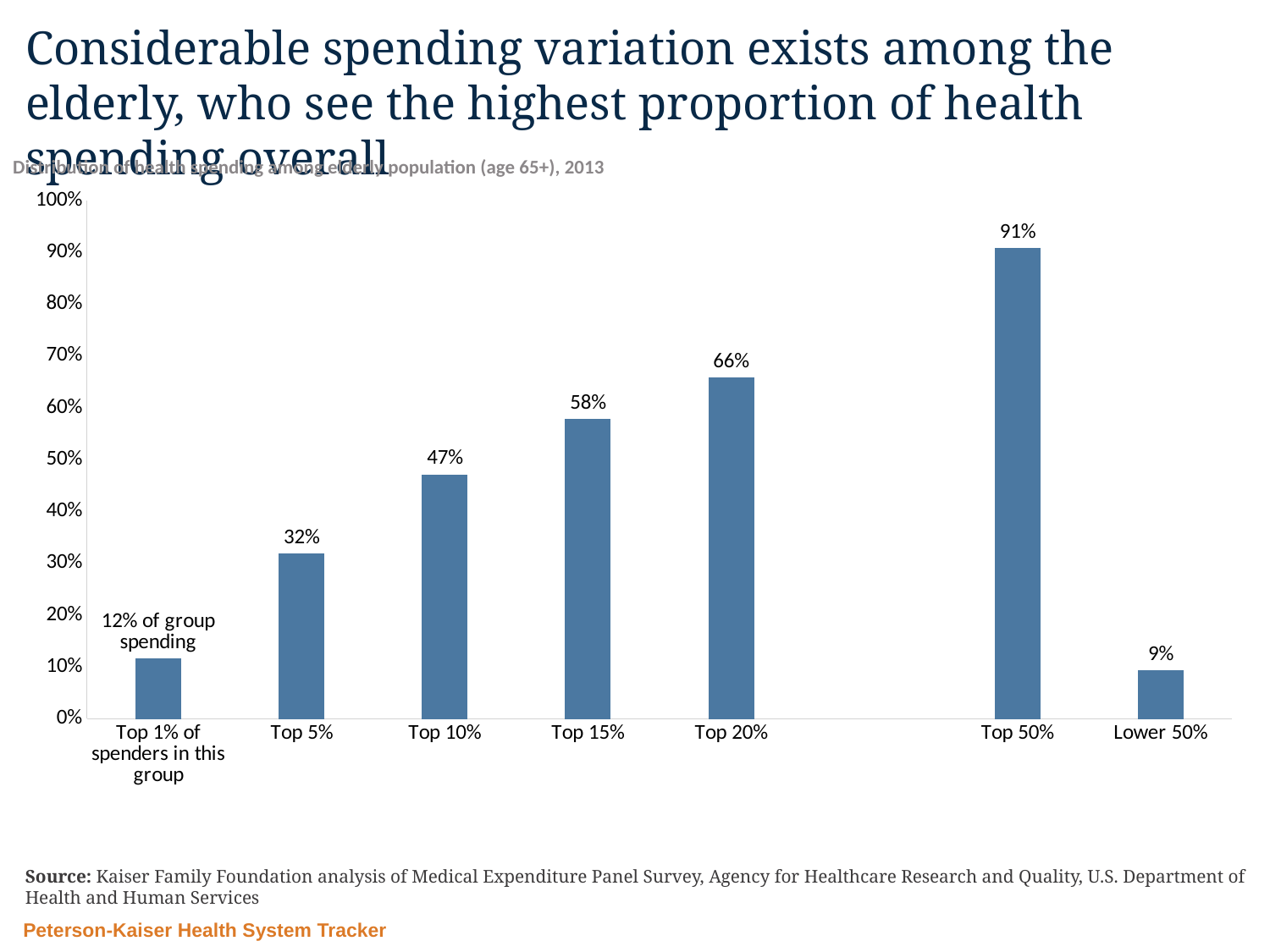
What is the difference between the values for Top 15% and Top 10%? 11% What value is shown for the Top 20% category? 66% Which category has the highest value on the chart? Top 50% What value is shown for the Top 1% of spenders in this group? 12% Is the value for Top 15% greater or less than 50%? greater What percentage of group spending is attributed to the top 5% of spenders? 32% Which is larger, the value for Top 10% or the value for Top 5%? Top 10% Which category has the lowest value on the chart? Lower 50% What is the difference between the values for Top 50% and Lower 50%? 82% What kind of chart is shown on the slide? Bar chart What share of spending is shown for the Lower 50% category? 9% How many categories are shown on the x axis of the chart? 7